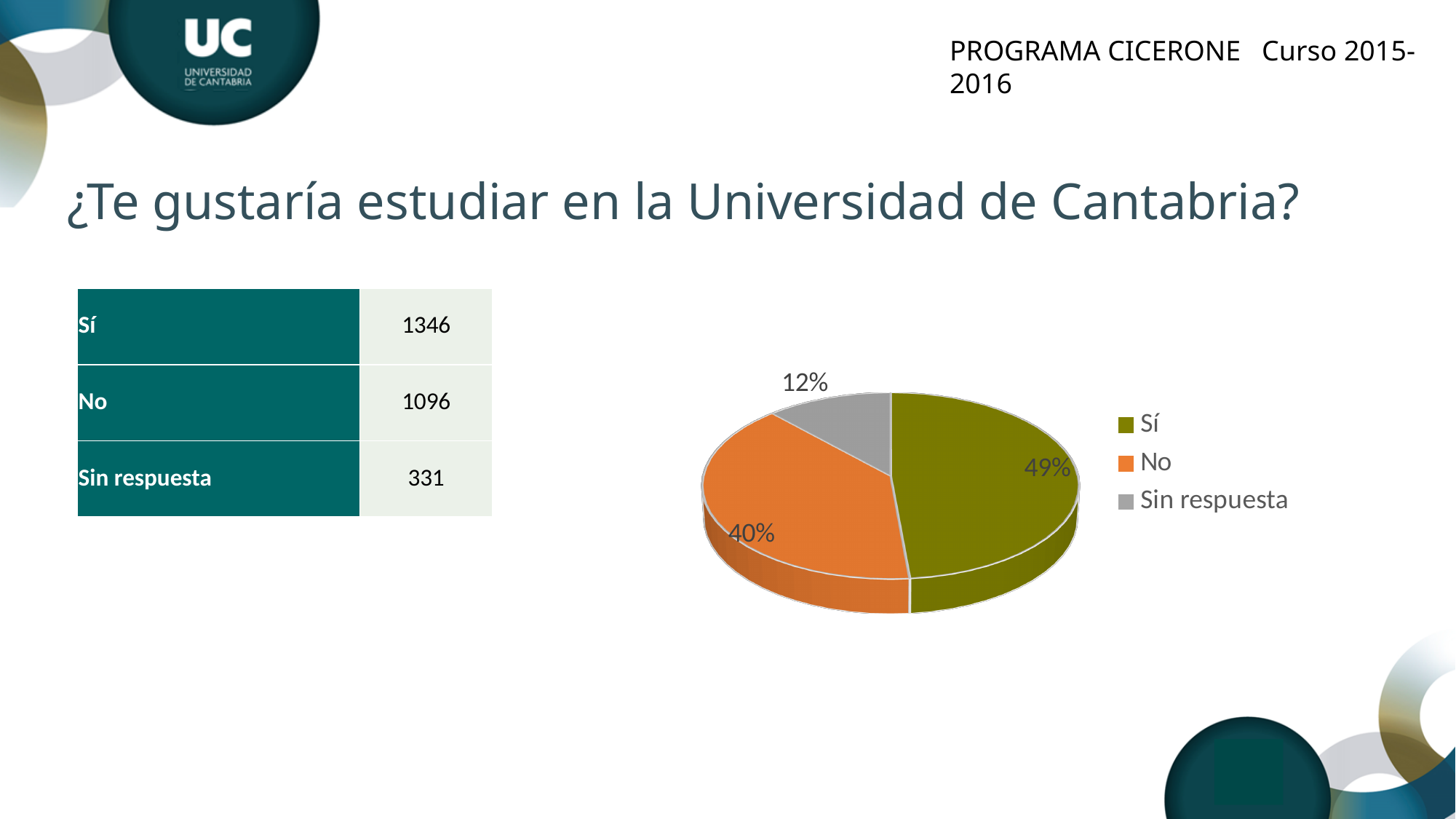
How many entries does the legend list? 3 Which category has the largest slice of the pie? Sí Which legend entry is shown in grey? Sin respuesta How many slices does the pie chart have? 3 What kind of chart is shown on the slide? pie chart What share of the pie does the 'Sin respuesta' slice represent? 12% What share of the pie does the 'Sí' slice represent? 49% What share of the pie does the 'No' slice represent? 40% What is the difference in percentage points between the 'Sí' and 'No' slices? 9% Which category has the smallest slice of the pie? Sin respuesta Which slice is larger, 'No' or 'Sin respuesta'? No What colour is the 'No' slice in the pie chart? orange